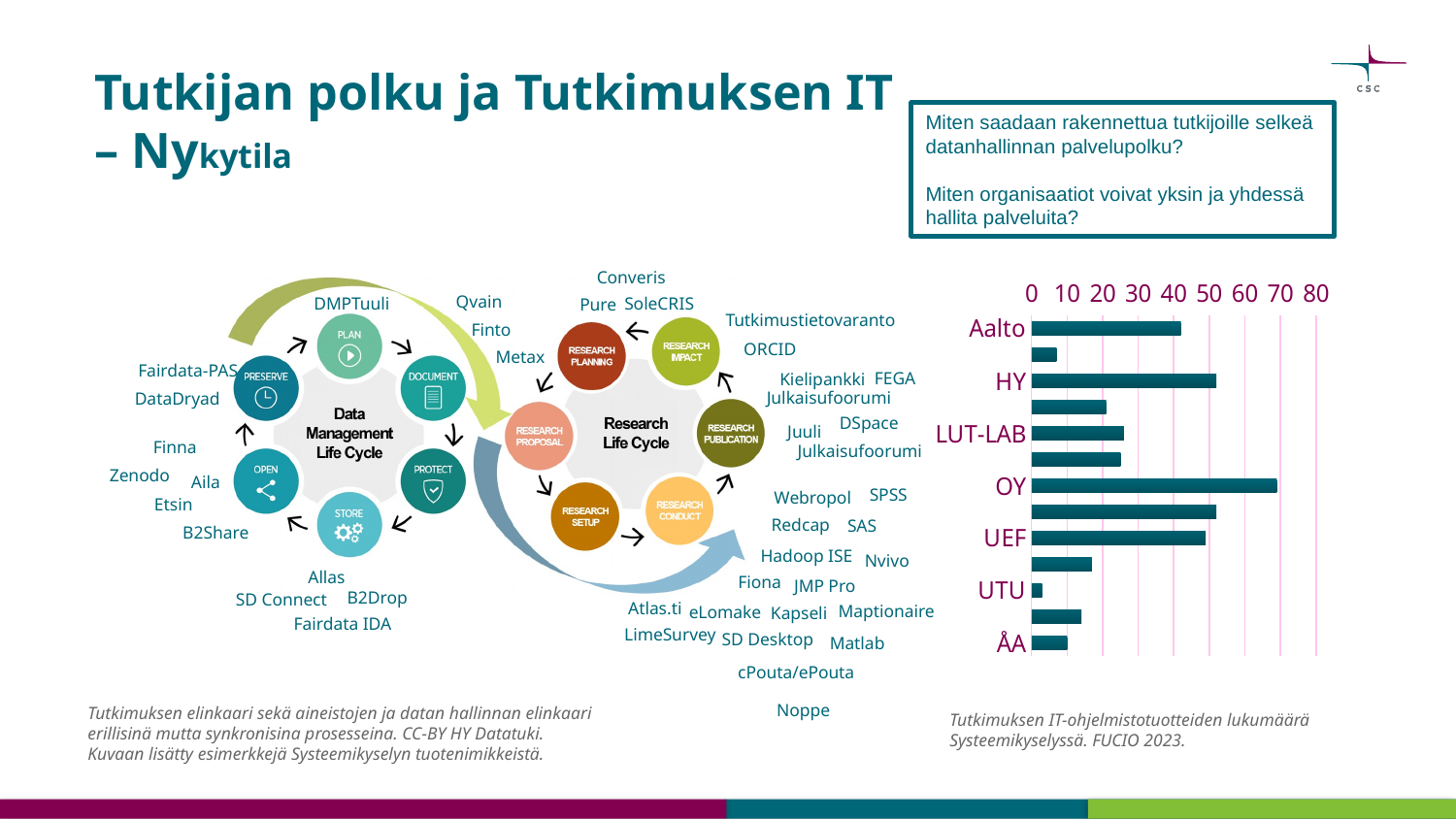
In the bar chart on the right, is the value for OY greater or less than 60? greater In the bar chart on the right, is the value for UTU greater or less than 10? less What is the highest tick value shown on the axis of the bar chart on the right? 80 In the bar chart on the right, is the value for Aalto greater or less than 30? greater In the bar chart on the right, which is larger, the value for OY or the value for UEF? OY In the bar chart on the right, which labelled organisation has the lowest value? UTU In the bar chart on the right, which is larger, the value for HY or the value for Aalto? HY What kind of chart is shown on the right side of the slide? bar chart In the bar chart on the right, which labelled organisation has the highest value? OY